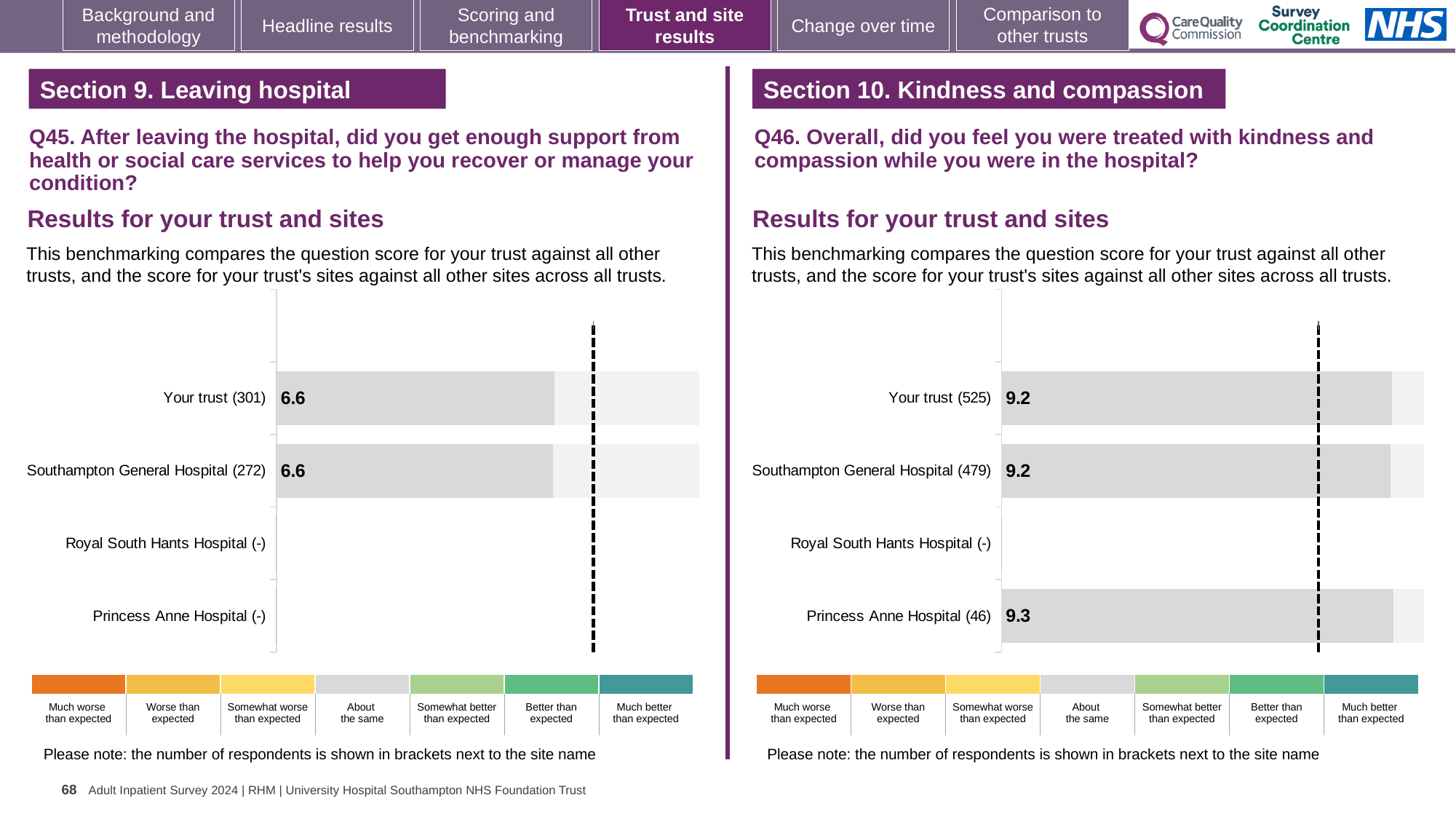
What kind of chart is used for the Q45 results on the left? Bar chart In the Q45 chart on the left, how many categories are listed on the vertical axis? 4 In the Q45 chart on the left, what is the score for Southampton General Hospital? 6.6 In the Q46 chart on the right, how many respondents are shown in brackets for Southampton General Hospital? 479 In the Q46 chart on the right, what is the score for Princess Anne Hospital? 9.3 In the Q45 chart on the left, how many respondents are shown in brackets for Your trust? 301 In the Q46 chart on the right, what is the score for Your trust? 9.2 In the Q46 chart on the right, what is the score for Southampton General Hospital? 9.2 In the Q46 chart on the right, what is the difference between the score for Princess Anne Hospital and the score for Your trust? 0.1 In the Q46 chart on the right, which site has the highest score? Princess Anne Hospital In the Q45 chart on the left, what is the score for Your trust? 6.6 In the Q46 chart on the right, is the score for Princess Anne Hospital larger or smaller than the score for Southampton General Hospital? Larger